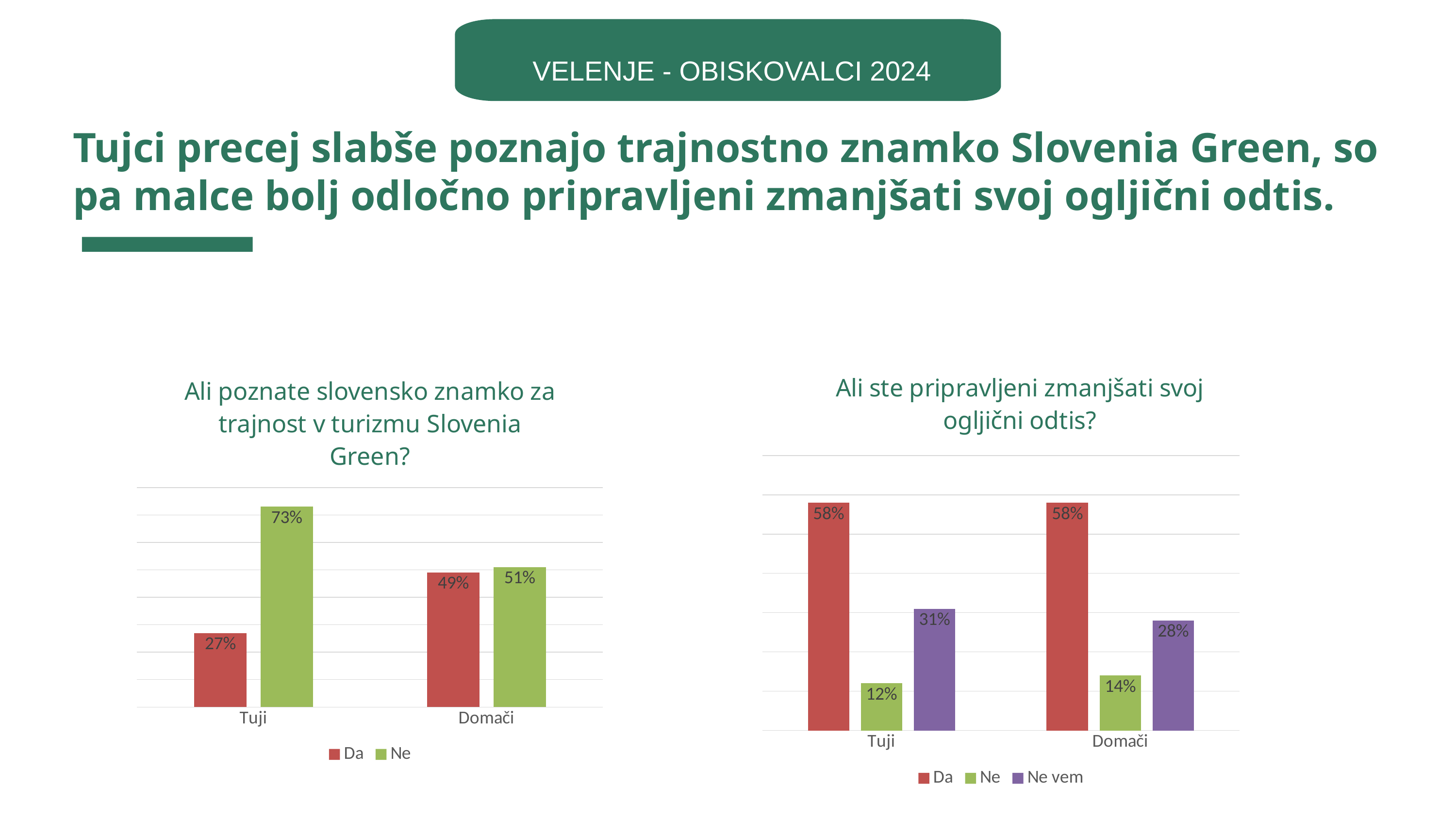
In the right chart (Ali ste pripravljeni zmanjšati svoj ogljični odtis?), how many series does the legend list? 3 In the left chart (Ali poznate slovensko znamko za trajnost v turizmu Slovenia Green?), which bar is the lowest? Da for Tuji (27%) In the left chart (Ali poznate slovensko znamko za trajnost v turizmu Slovenia Green?), how many series does the legend list? 2 In the right chart (Ali ste pripravljeni zmanjšati svoj ogljični odtis?), what is the value for Ne vem among Tuji? 31% In the right chart (Ali ste pripravljeni zmanjšati svoj ogljični odtis?), which is larger: Ne vem for Tuji or Ne vem for Domači? Ne vem for Tuji In the left chart (Ali poznate slovensko znamko za trajnost v turizmu Slovenia Green?), what is the difference between Ne and Da for Tuji? 46% In the right chart (Ali ste pripravljeni zmanjšati svoj ogljični odtis?), what colour represents the Ne vem series? Purple In the left chart (Ali poznate slovensko znamko za trajnost v turizmu Slovenia Green?), what is the value for Ne among Tuji? 73% What kind of chart is the right chart (Ali ste pripravljeni zmanjšati svoj ogljični odtis?)? Bar chart In the right chart (Ali ste pripravljeni zmanjšati svoj ogljični odtis?), what is the difference between Da and Ne for Tuji? 46% In the left chart (Ali poznate slovensko znamko za trajnost v turizmu Slovenia Green?), what is the value for Da among Domači? 49% In the right chart (Ali ste pripravljeni zmanjšati svoj ogljični odtis?), what is the value for Ne among Domači? 14%